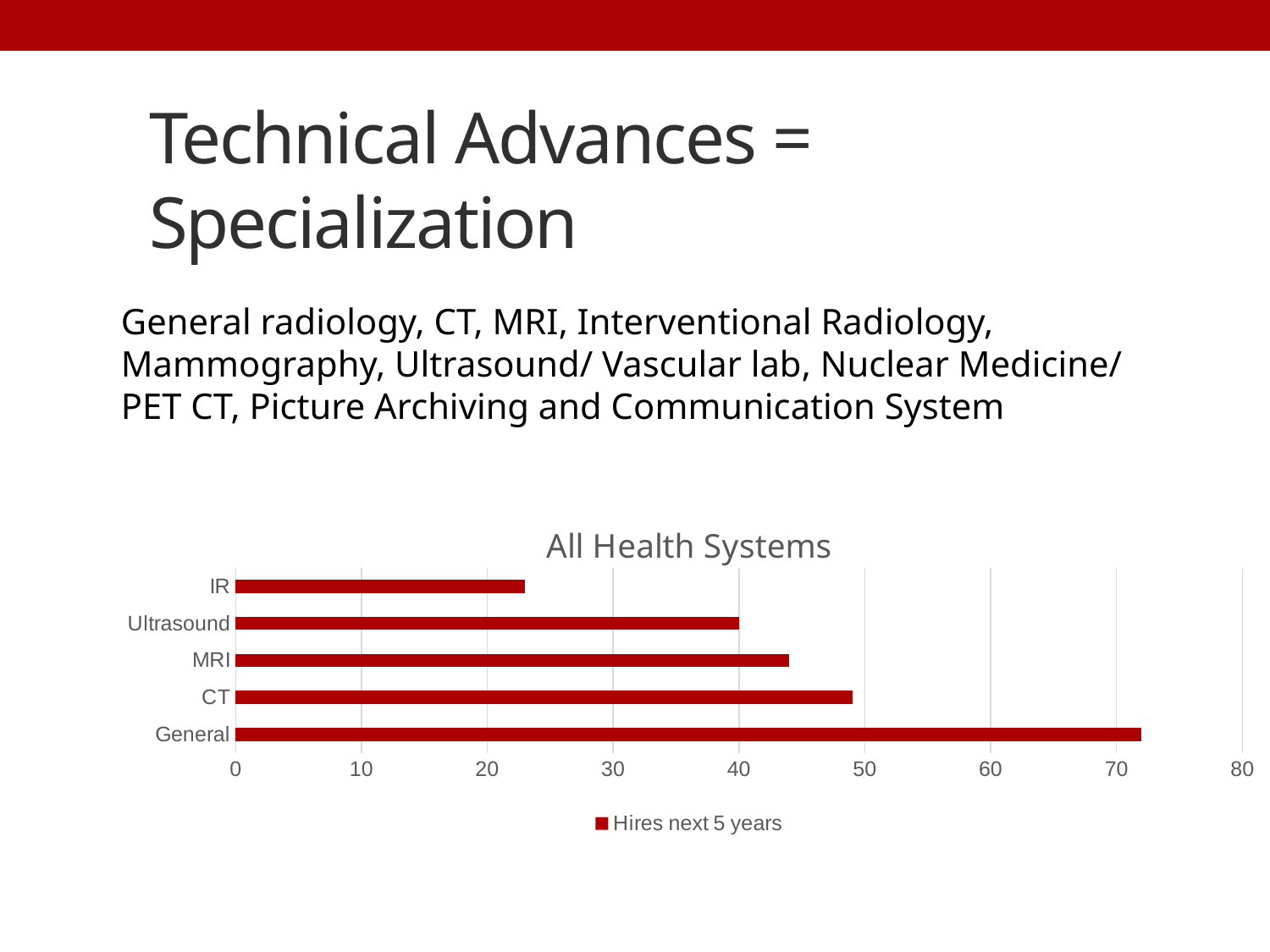
Which has a larger value, General or Ultrasound? General What is the title of the chart? All Health Systems What series does the chart's legend list? Hires next 5 years Is the value for IR greater or less than 30? less How many series does the legend list? 1 Is the value for General greater or less than 60? greater Which has a larger value, CT or MRI? CT How many categories are plotted in the chart? 5 Which category has the highest value for Hires next 5 years? General What kind of chart is shown on the slide? bar chart Is the value for MRI greater or less than 40? greater Which category has the lowest value for Hires next 5 years? IR